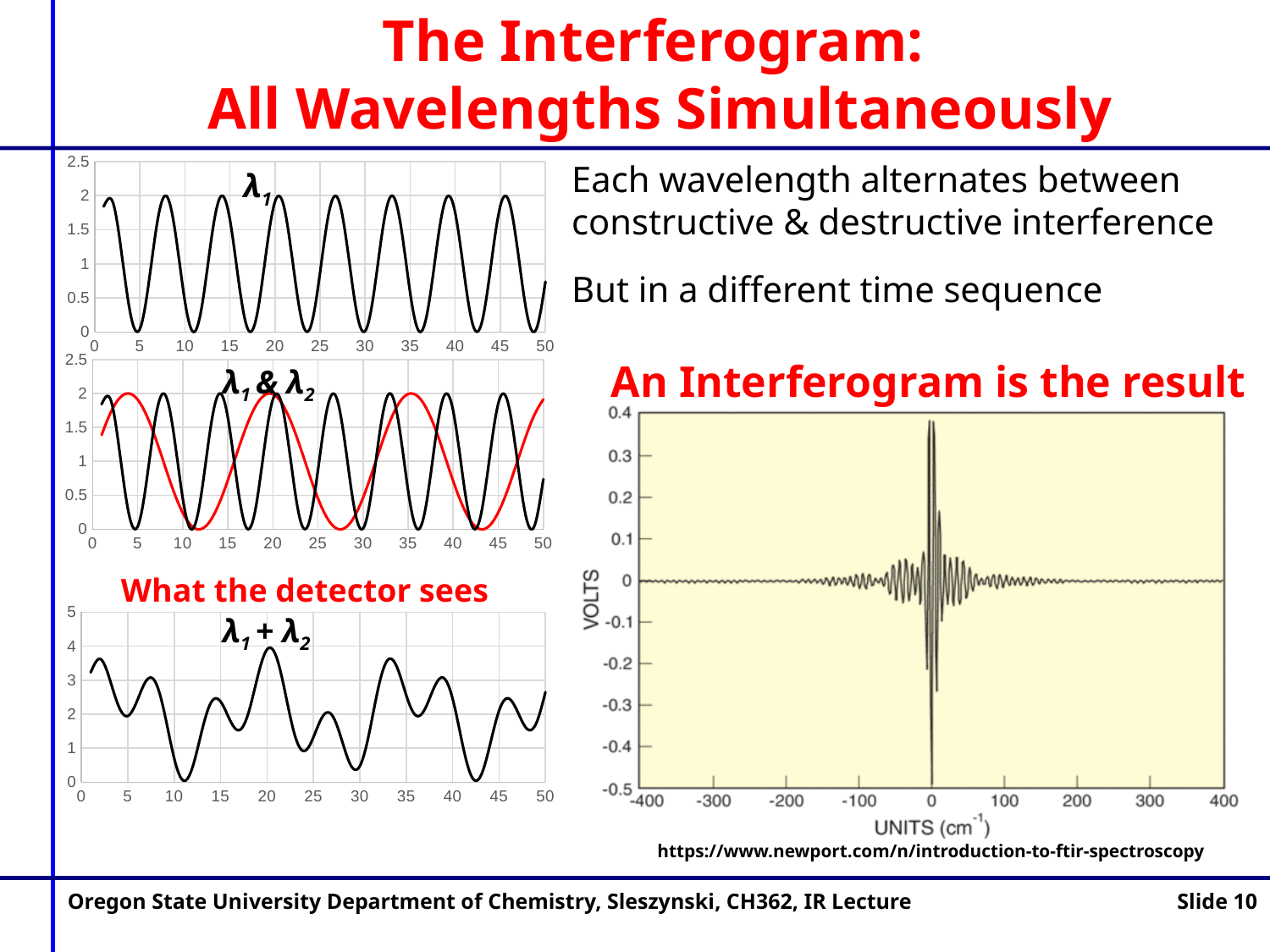
In the top-left chart labelled λ1, is the peak value of the curve greater or less than 1.5? greater In the interferogram chart on the right, is the largest positive peak at 0 cm⁻¹ greater or less than 0.3 volts? greater In the middle-left chart labelled λ1 & λ2, what colour is the λ2 curve? red In the interferogram chart on the right, at which x-axis value does the signal reach its maximum? 0 What is the y-axis label of the interferogram chart on the right? VOLTS In the interferogram chart on the right, is the lowest value of the signal greater or less than -0.2 volts? less How many series are plotted in the middle-left chart labelled λ1 & λ2? 2 In the bottom-left chart labelled λ1 + λ2, near which x-axis tick does the curve reach its highest peak? 20 What is the maximum value shown on the y axis of the bottom-left chart labelled λ1 + λ2? 5 What kind of chart is the top-left chart labelled λ1? line chart